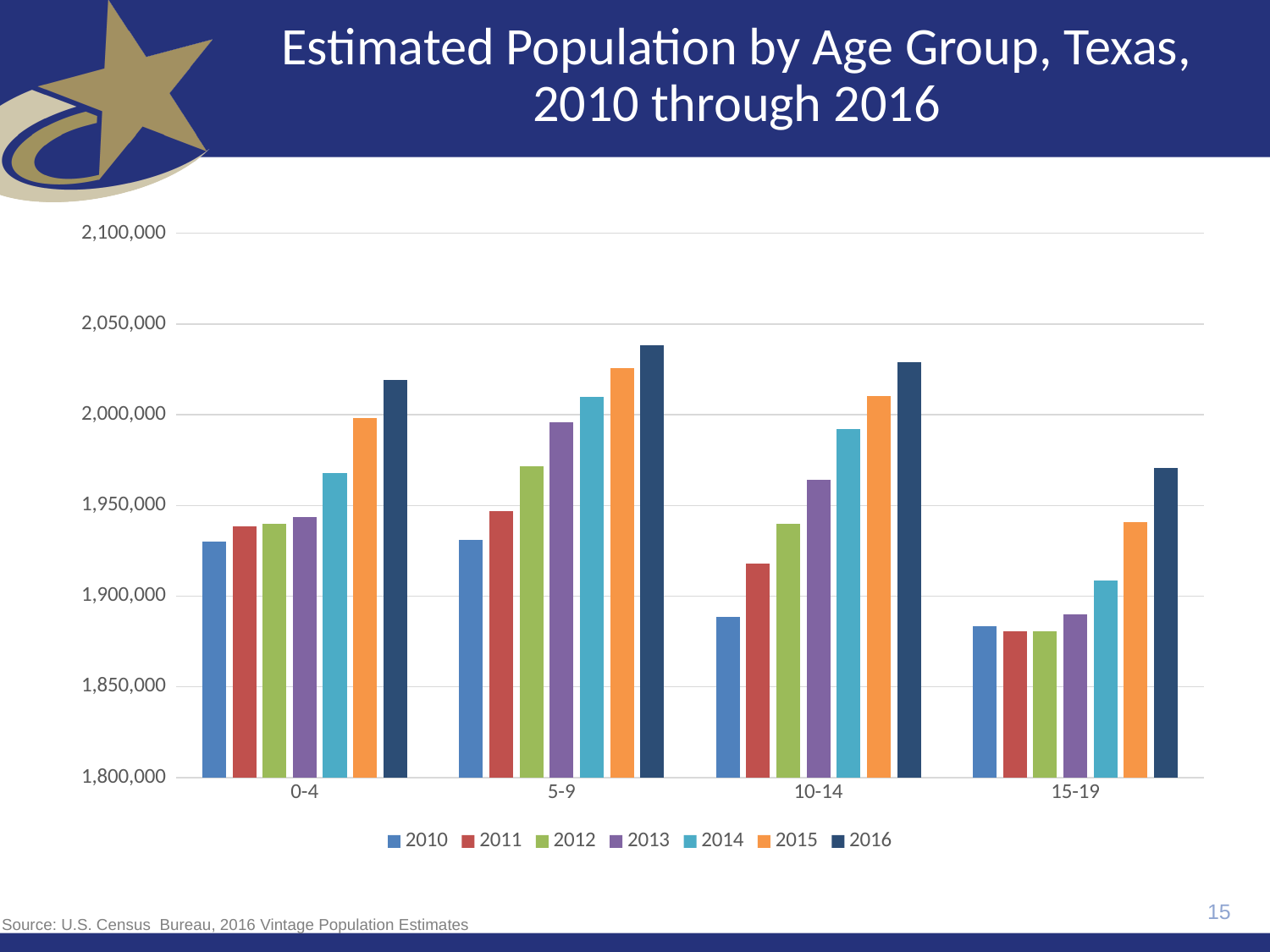
Is the 2016 value for the 5-9 age group greater or less than 2,000,000? greater Which age group has the lowest 2016 value? 15-19 How many series does the legend list? 7 Within the 5-9 age group, do the values rise or fall from 2010 to 2016? rise What kind of chart is shown on the slide? Bar chart Is the 2016 value for the 15-19 age group greater or less than 2,000,000? less Which is larger: the 2015 value for the 0-4 age group or the 2015 value for the 15-19 age group? 0-4 How many age groups are shown on the x axis? 4 Is the 2010 value for the 10-14 age group greater or less than 1,900,000? less Which age group has the highest 2016 value? 5-9 What is the title of the chart? Estimated Population by Age Group, Texas, 2010 through 2016